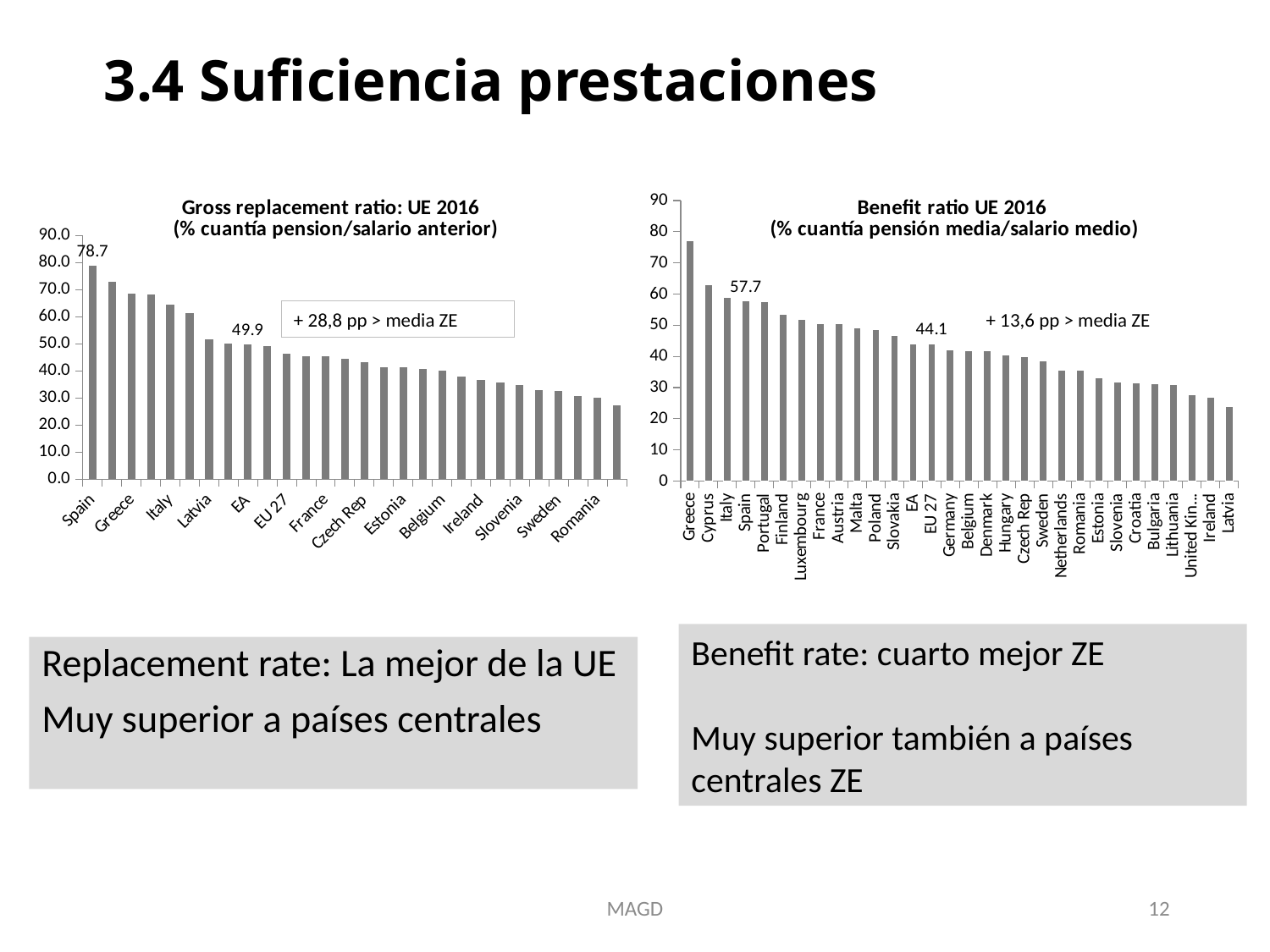
In the Gross replacement ratio chart on the left, what is the value for Spain? 78.7 In the Benefit ratio chart on the right, which country has the highest value? Greece What kind of chart is the Benefit ratio chart on the right? Bar chart In the Benefit ratio chart on the right, which country has the lowest value? Latvia In the Gross replacement ratio chart on the left, what is the difference between the values for Spain and EA? 28.8 In the Benefit ratio chart on the right, what is the value for EA? 44.1 In the Gross replacement ratio chart on the left, what is the value for EA? 49.9 In the Gross replacement ratio chart on the left, which country has the highest value? Spain In the Benefit ratio chart on the right, what is the value for Spain? 57.7 In the Benefit ratio chart on the right, is the value for Greece greater or less than 70? greater